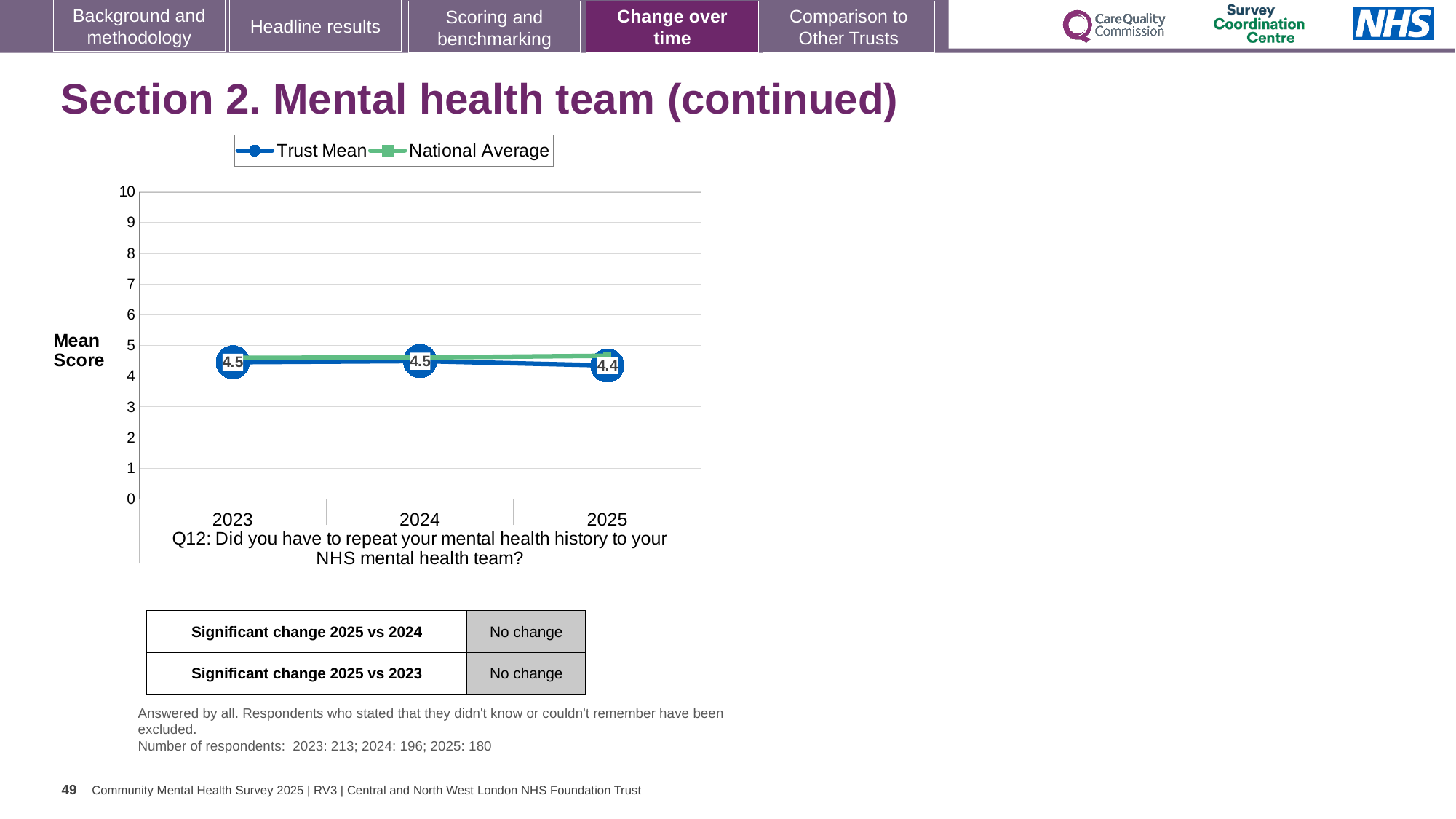
How many series does the legend list? 2 What is the difference between the Trust Mean score in 2023 and in 2025? 0.1 In which year is the Trust Mean score lowest? 2025 How many years are plotted on the x axis? 3 What is the Trust Mean score for 2023? 4.5 What kind of chart is shown on the slide? line chart Does the Trust Mean rise or fall from 2024 to 2025? fall What is the Trust Mean score for 2024? 4.5 What is the Trust Mean score for 2025? 4.4 Which is larger, the Trust Mean score for 2024 or for 2025? 2024 Is the Trust Mean value for 2025 greater or less than 5? less Is the National Average value for 2025 greater or less than 4? greater